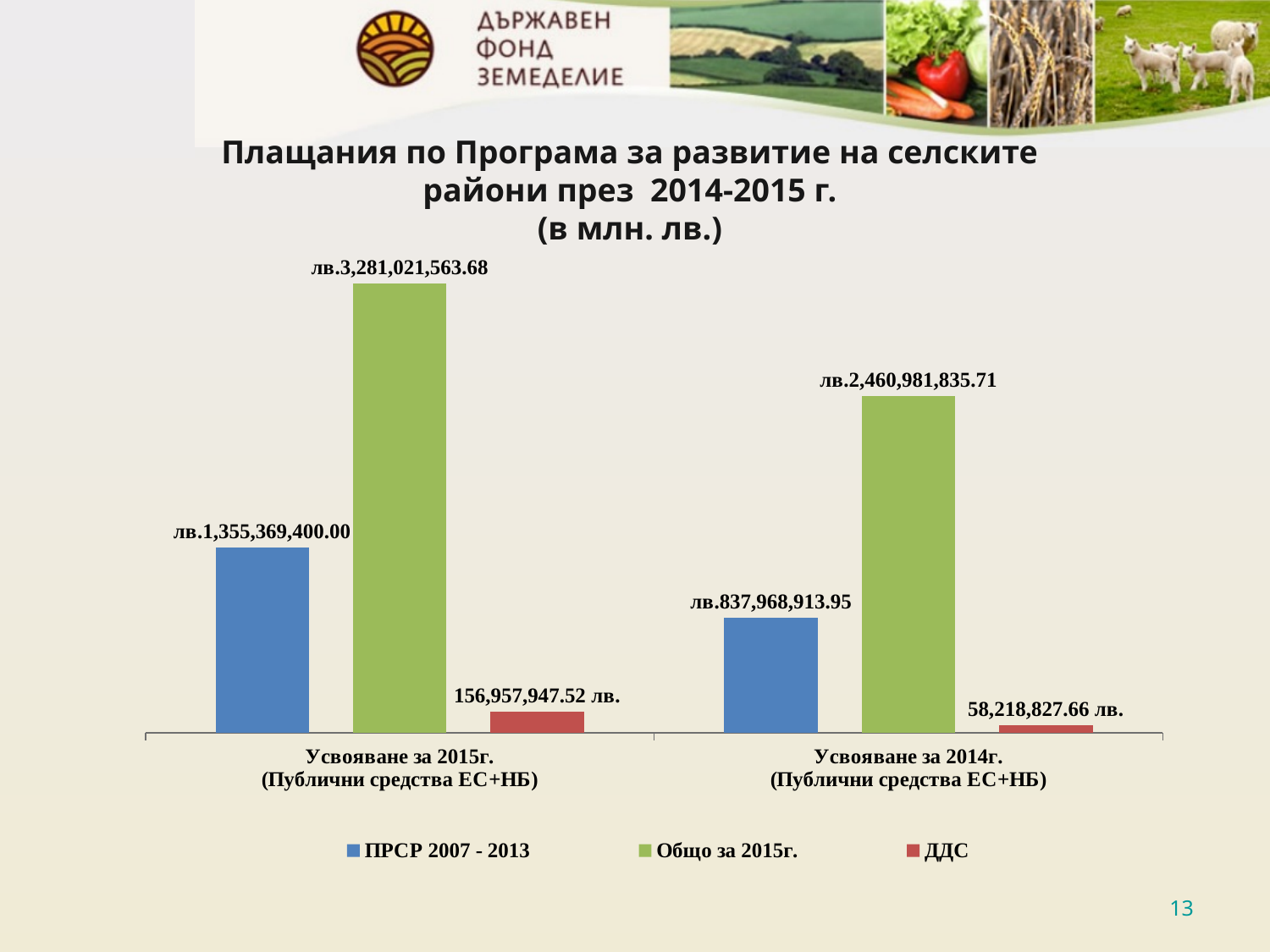
Which series has the highest value for "Усвояване за 2015г. (Публични средства ЕС+НБ)"? Общо за 2015г. How many categories are shown on the x axis? 2 What is the value of "Общо за 2015г." for "Усвояване за 2015г. (Публични средства ЕС+НБ)"? лв.3,281,021,563.68 What is the value of "ДДС" for "Усвояване за 2015г. (Публични средства ЕС+НБ)"? 156,957,947.52 лв. Is the "ПРСР 2007 - 2013" value larger for "Усвояване за 2015г." or for "Усвояване за 2014г."? Усвояване за 2015г. Which series is shown in red in the legend? ДДС What type of chart is shown on the slide? Bar chart What is the value of "ПРСР 2007 - 2013" for "Усвояване за 2014г. (Публични средства ЕС+НБ)"? лв.837,968,913.95 What is the value of "Общо за 2015г." for "Усвояване за 2014г. (Публични средства ЕС+НБ)"? лв.2,460,981,835.71 What is the difference between the "Общо за 2015г." values for 2015 and 2014? лв.820,039,727.97 Which series has the lowest value for "Усвояване за 2014г. (Публични средства ЕС+НБ)"? ДДС How many series does the legend list? 3